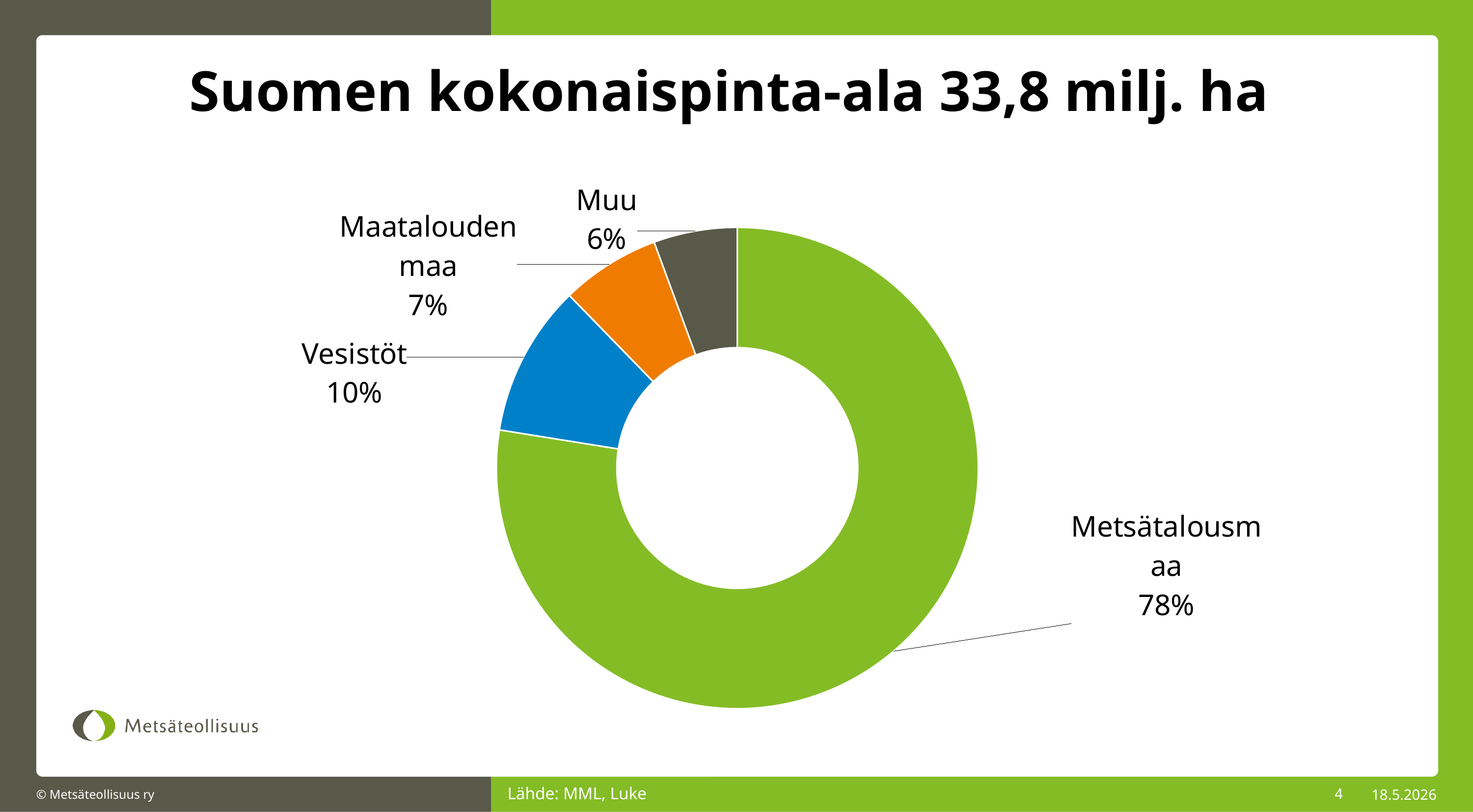
What kind of chart is shown on the slide? doughnut chart How many percentage points larger is the share of Maatalouden maa than the share of Muu? 1 What share of the total area is Maatalouden maa? 7% How many categories are shown in the chart? 4 What is the title of the slide? Suomen kokonaispinta-ala 33,8 milj. ha How many percentage points larger is the share of Metsätalousmaa than the share of Vesistöt? 68 Which category has the largest share of the total area? Metsätalousmaa What share of Finland's total area is Metsätalousmaa? 78% What share of the total area is Vesistöt? 10% Which category has the smallest share of the total area? Muu What share of the total area is Muu? 6% Which has a larger share, Vesistöt or Maatalouden maa? Vesistöt